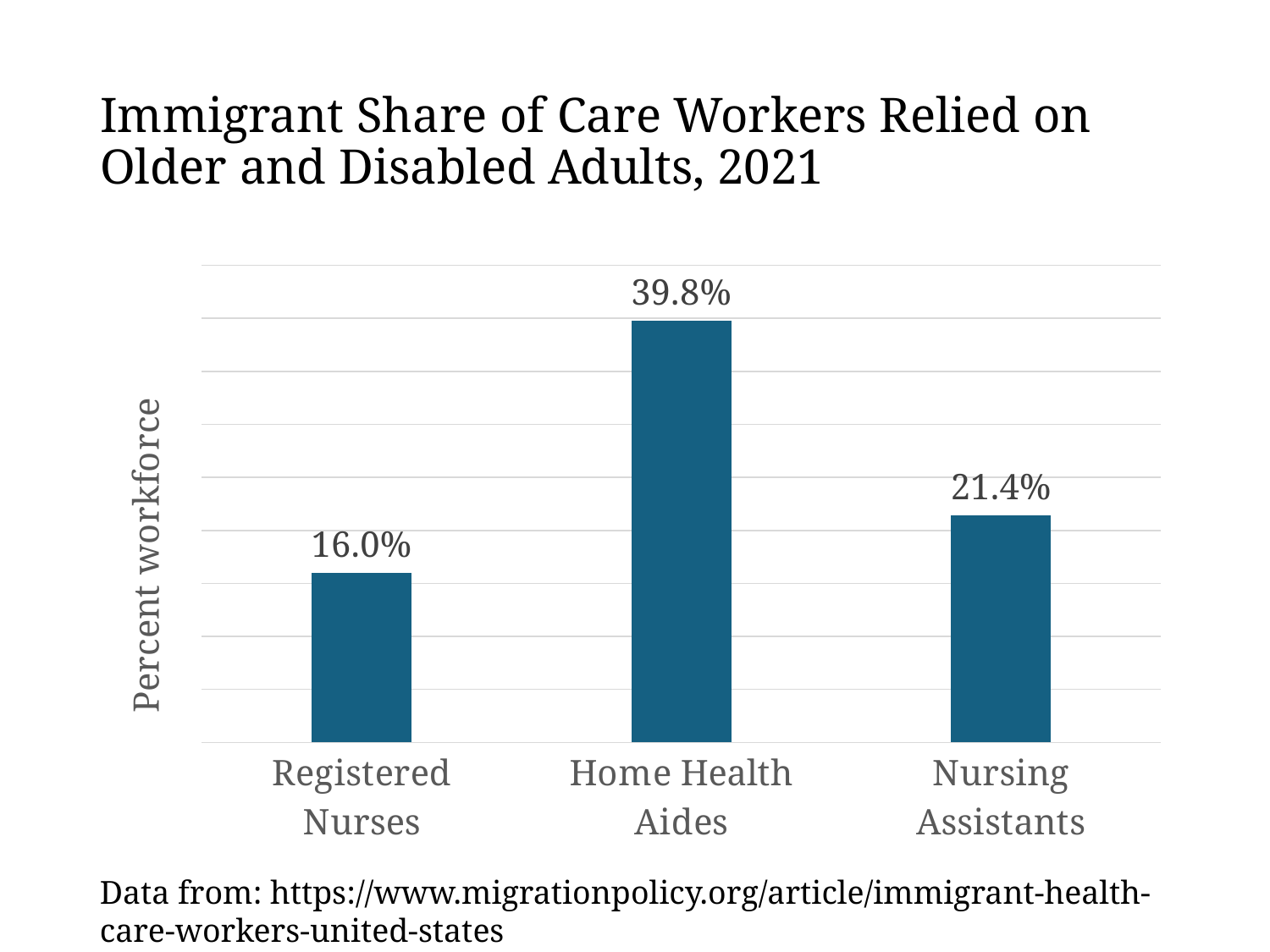
What is the label on the vertical axis of the chart? Percent workforce How many occupations are shown in the chart? 3 Which has a larger immigrant share: Nursing Assistants or Registered Nurses? Nursing Assistants What kind of chart is shown on the slide? Bar chart What is the immigrant share of the workforce for Nursing Assistants? 21.4% What is the difference in immigrant share between Nursing Assistants and Registered Nurses? 5.4% Which occupation has the lowest immigrant share of its workforce? Registered Nurses What year does the chart title say the data is for? 2021 What is the immigrant share of the workforce for Home Health Aides? 39.8% Which occupation has the highest immigrant share of its workforce? Home Health Aides What is the immigrant share of the workforce for Registered Nurses? 16.0% What is the difference in immigrant share between Home Health Aides and Registered Nurses? 23.8%